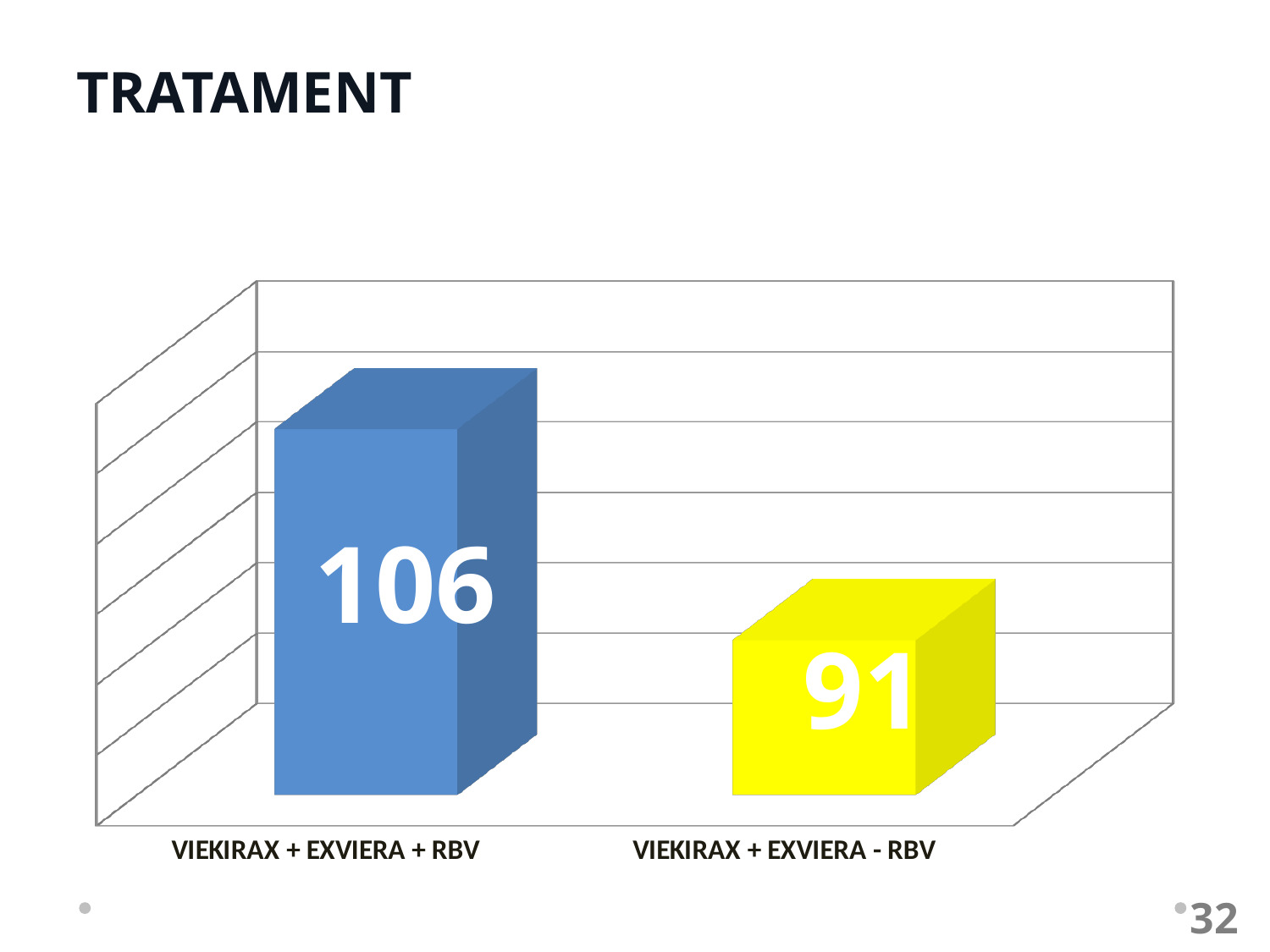
What is the value for VIEKIRAX + EXVIERA + RBV? 106 What is the difference between the values for VIEKIRAX + EXVIERA + RBV and VIEKIRAX + EXVIERA - RBV? 15 Which is larger, the value for VIEKIRAX + EXVIERA + RBV or the value for VIEKIRAX + EXVIERA - RBV? VIEKIRAX + EXVIERA + RBV What is the title of the slide? TRATAMENT What kind of chart is shown on the slide? bar chart What is the total of the two values shown in the chart? 197 What is the value for VIEKIRAX + EXVIERA - RBV? 91 Which category has the highest value? VIEKIRAX + EXVIERA + RBV Which category has the lowest value? VIEKIRAX + EXVIERA - RBV What colour is the bar for VIEKIRAX + EXVIERA - RBV? yellow How many categories are shown in the chart? 2